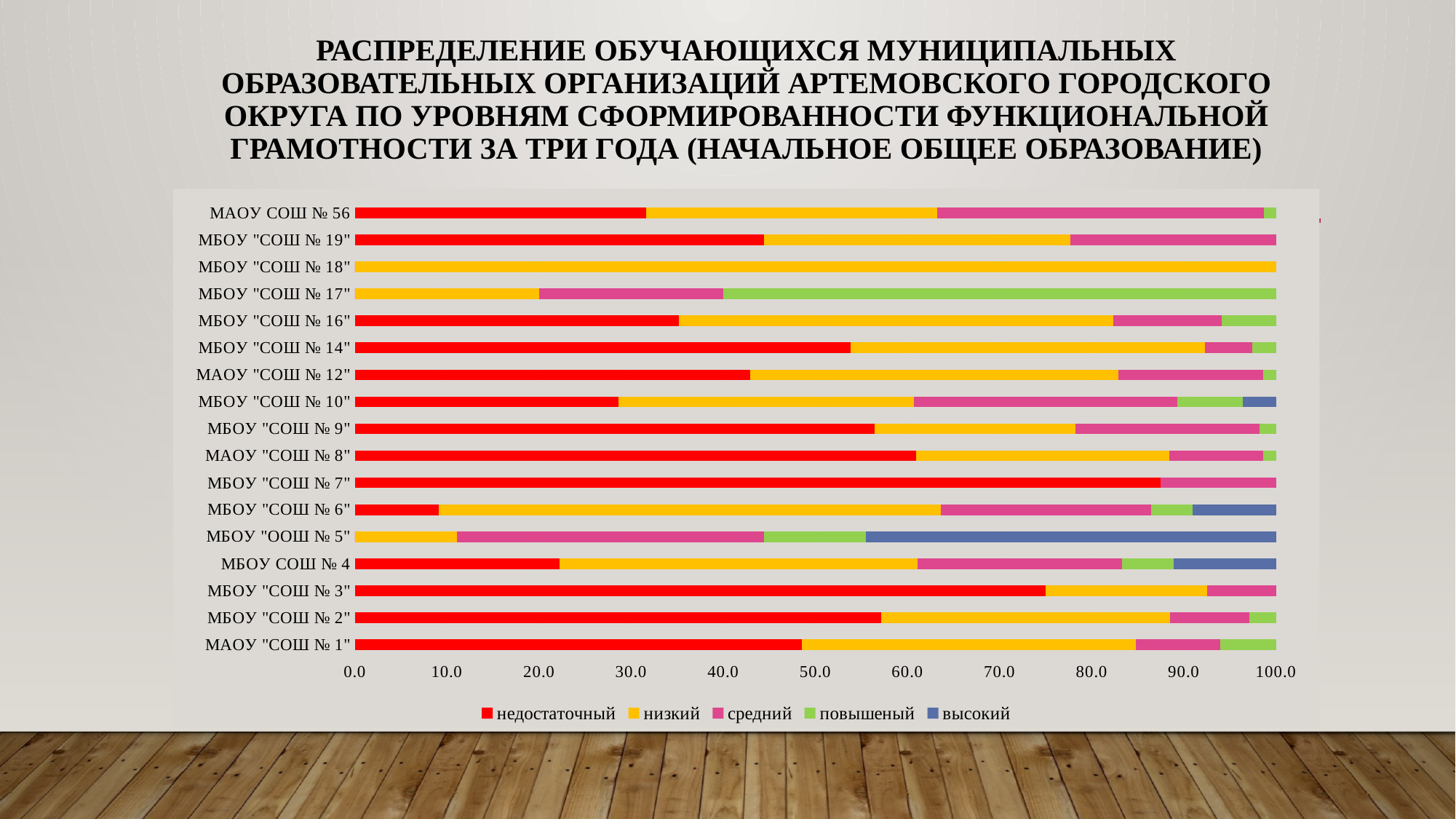
What is the maximum value shown on the horizontal axis? 100.0 Which has the larger недостаточный segment, МБОУ "СОШ № 9" or МБОУ СОШ № 4? МБОУ "СОШ № 9" Which school has the largest высокий segment? МБОУ "ООШ № 5" How many schools (categories) are plotted on the chart? 17 Is the недостаточный value for МБОУ "СОШ № 7" greater or less than 80? greater How many series does the legend list? 5 What kind of chart is shown on the slide? Stacked bar chart What is the value of the низкий series for МБОУ "СОШ № 18"? 100.0 Which school has the largest недостаточный segment? МБОУ "СОШ № 7" Which series is shown in red in the legend? недостаточный Which school has the largest повышеный segment? МБОУ "СОШ № 17"